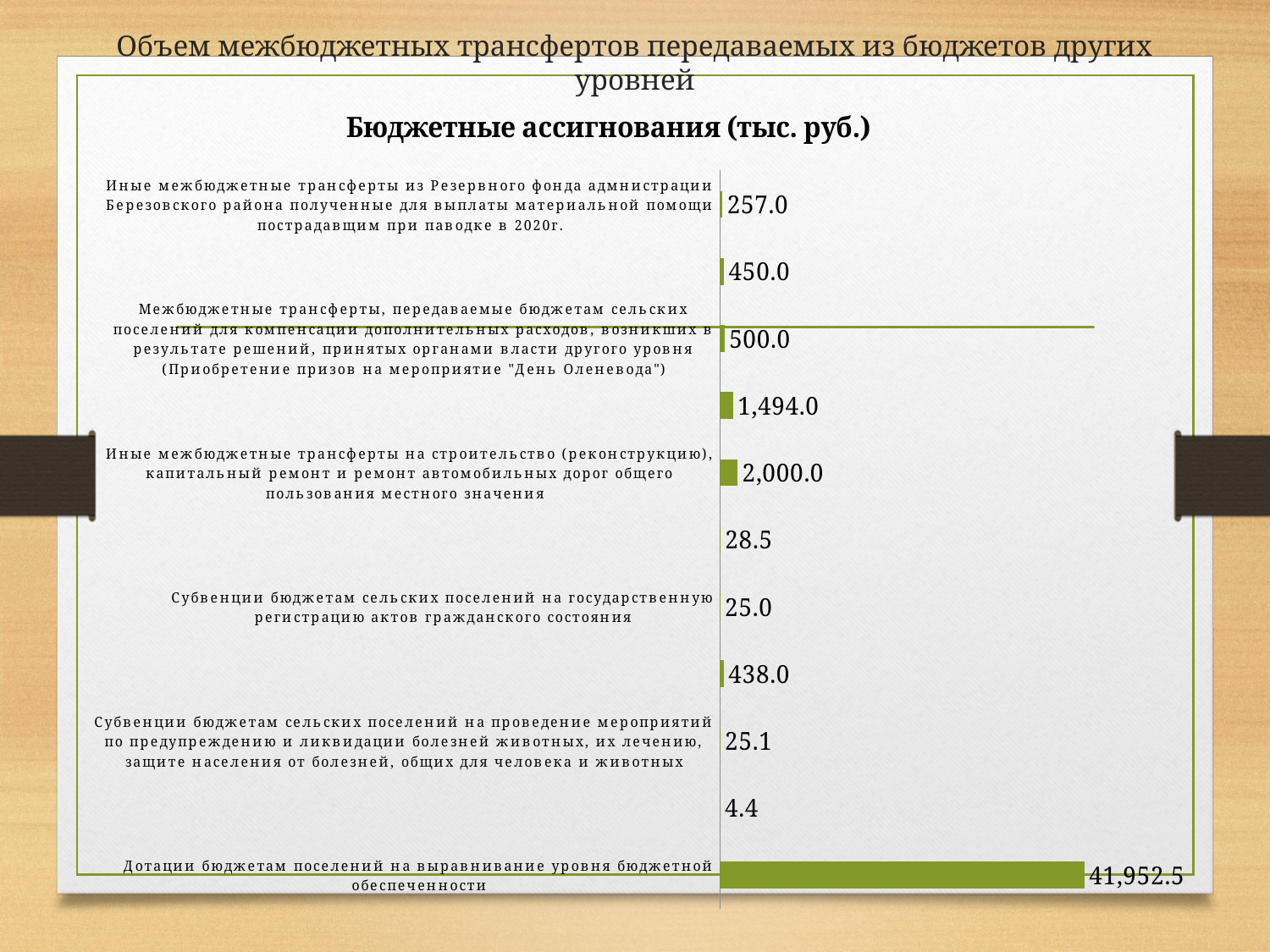
What is the value for 'Дотации бюджетам поселений на выравнивание уровня бюджетной обеспеченности'? 41,952.5 What is the value for the category about 'Приобретение призов на мероприятие "День Оленевода"'? 500.0 What is the value for 'Иные межбюджетные трансферты из Резервного фонда администрации Березовского района полученные для выплаты материальной помощи пострадавшим при паводке в 2020г.'? 257.0 What is the title of the chart? Бюджетные ассигнования (тыс. руб.) What kind of chart is shown on the slide? Bar chart How many bars are plotted in the chart? 11 What is the difference between the value for the road construction and repair transfers (2,000.0) and the 'День Оленевода' transfers (500.0)? 1,500.0 Which is larger: the value for 'Субвенции бюджетам сельских поселений на проведение мероприятий по предупреждению и ликвидации болезней животных...' or the value for 'Иные межбюджетные трансферты из Резервного фонда администрации Березовского района...'? Иные межбюджетные трансферты из Резервного фонда администрации Березовского района... What is the value for 'Иные межбюджетные трансферты на строительство (реконструкцию), капитальный ремонт и ремонт автомобильных дорог общего пользования местного значения'? 2,000.0 What is the value for 'Субвенции бюджетам сельских поселений на государственную регистрацию актов гражданского состояния'? 25.0 Which category has the highest value in the chart? Дотации бюджетам поселений на выравнивание уровня бюджетной обеспеченности What is the smallest value shown in the chart? 4.4